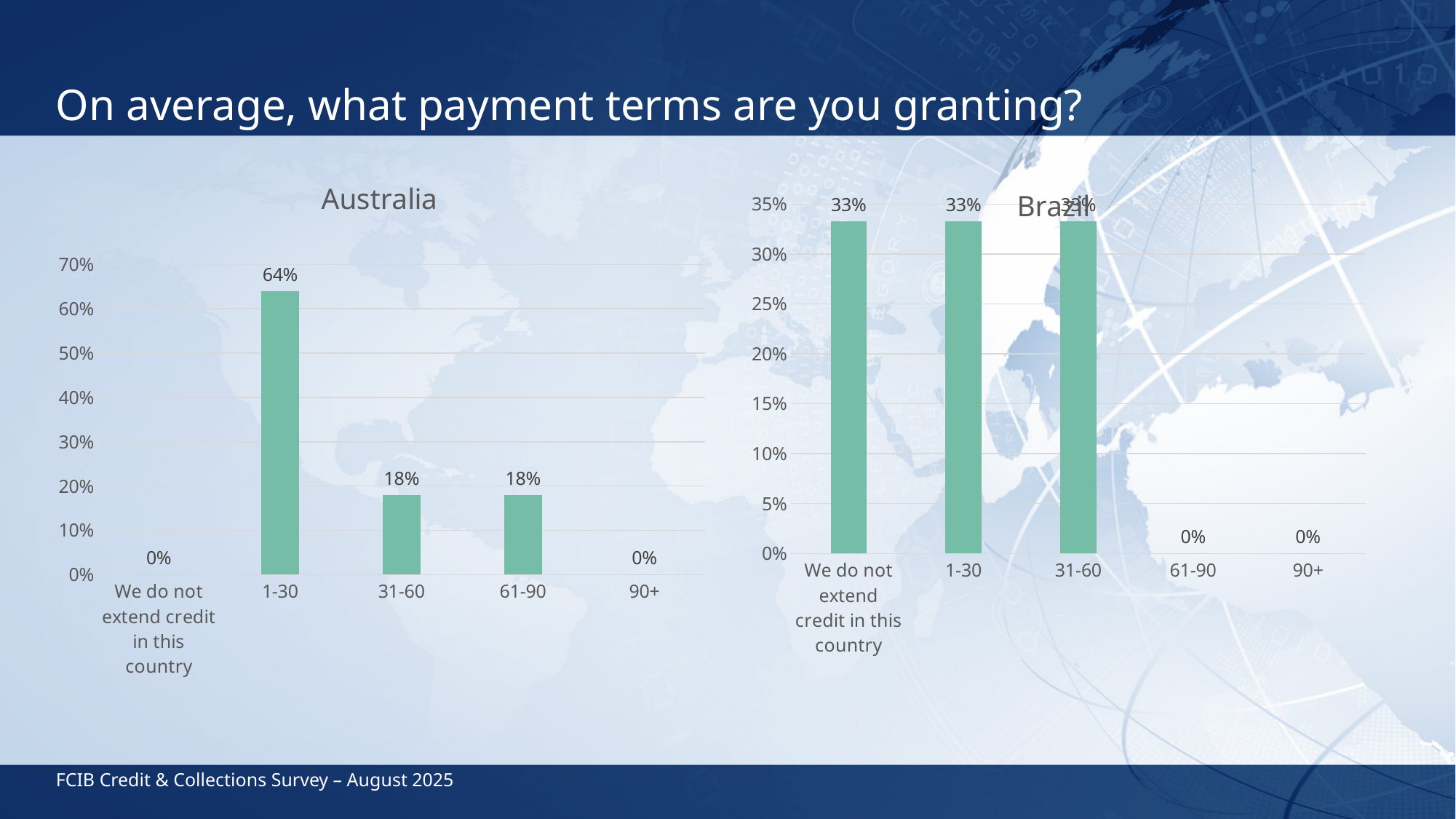
In the Australia chart, is the value for 1-30 greater or less than 60%? greater In the Brazil chart, which is larger, the value for 31-60 or the value for 61-90? 31-60 In the Australia chart, what is the value for 31-60? 18% In the Brazil chart, what is the value for 90+? 0% In the Brazil chart, what is the value for 1-30? 33% What kind of chart is the Brazil chart? bar chart In the Australia chart, what is the value for 1-30? 64% In the Australia chart, which category has the highest value? 1-30 In the Australia chart, how many categories are shown on the x axis? 5 In the Australia chart, what is the difference between the values for 1-30 and 61-90? 46% In the Brazil chart, what is the value for 'We do not extend credit in this country'? 33% What is the title of the chart on the left? Australia